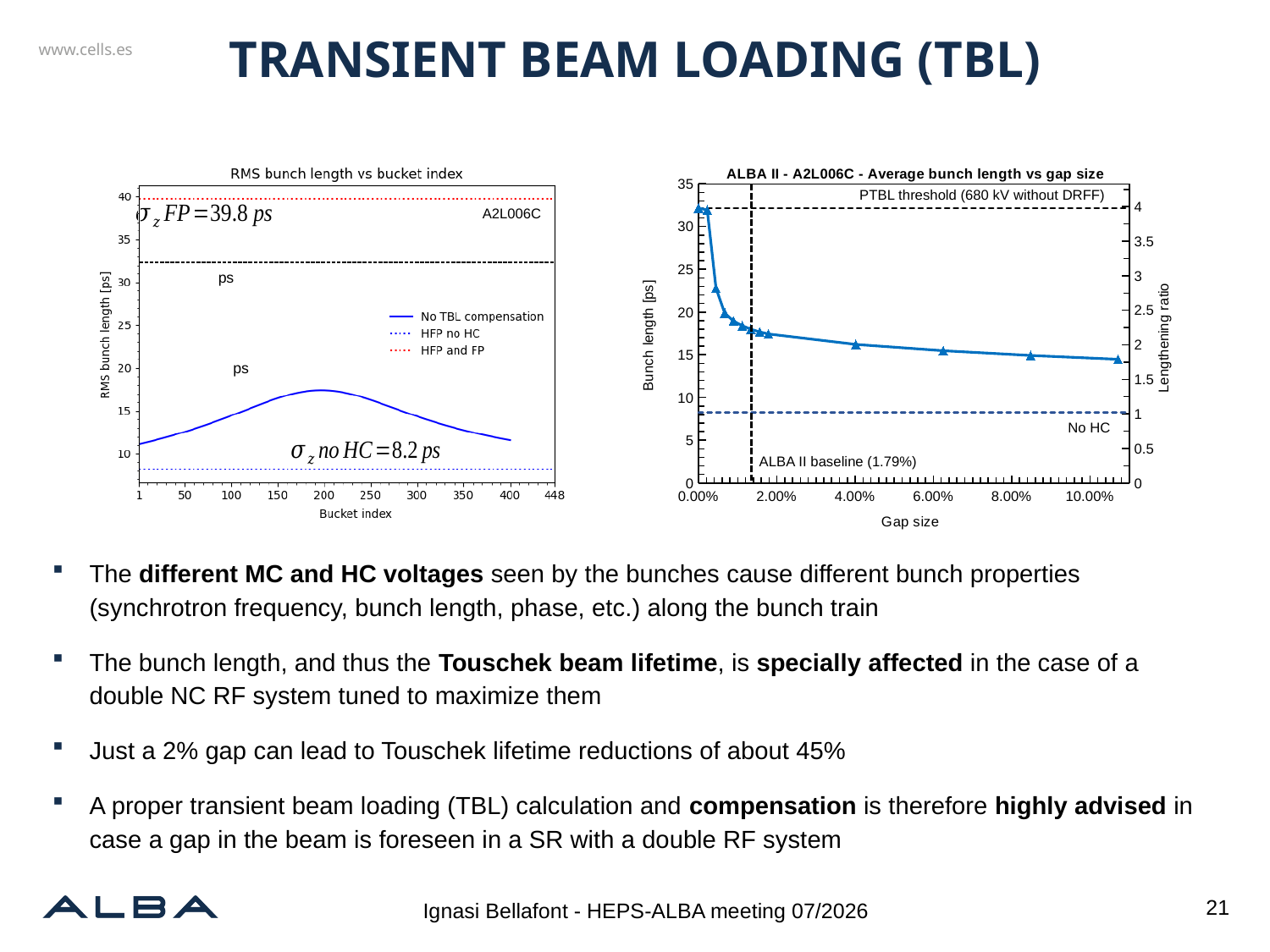
In the right chart 'Average bunch length vs gap size', does the bunch length rise or fall as the gap size increases? fall In the right chart 'Average bunch length vs gap size', is the bunch length at a gap size of 0.00% greater or less than 30? greater In the right chart 'Average bunch length vs gap size', what is the label of the secondary (right-hand) y axis? Lengthening ratio How many series does the legend of the left chart 'RMS bunch length vs bucket index' list? 3 What type of chart is the left chart titled 'RMS bunch length vs bucket index'? line chart In the right chart 'Average bunch length vs gap size', what voltage is given for the PTBL threshold? 680 kV without DRFF In the left chart 'RMS bunch length vs bucket index', what value is given for σz no HC? 8.2 ps In the left chart 'RMS bunch length vs bucket index', does the 'No TBL compensation' curve rise or fall between bucket index 1 and bucket index 200? rise In the left chart 'RMS bunch length vs bucket index', what value is given for σz FP? 39.8 ps In the right chart 'Average bunch length vs gap size', what gap size is marked as the ALBA II baseline? 1.79% In the left chart 'RMS bunch length vs bucket index', is the peak value of the 'No TBL compensation' curve greater or less than 20? less What is the title of the right chart? ALBA II - A2L006C - Average bunch length vs gap size